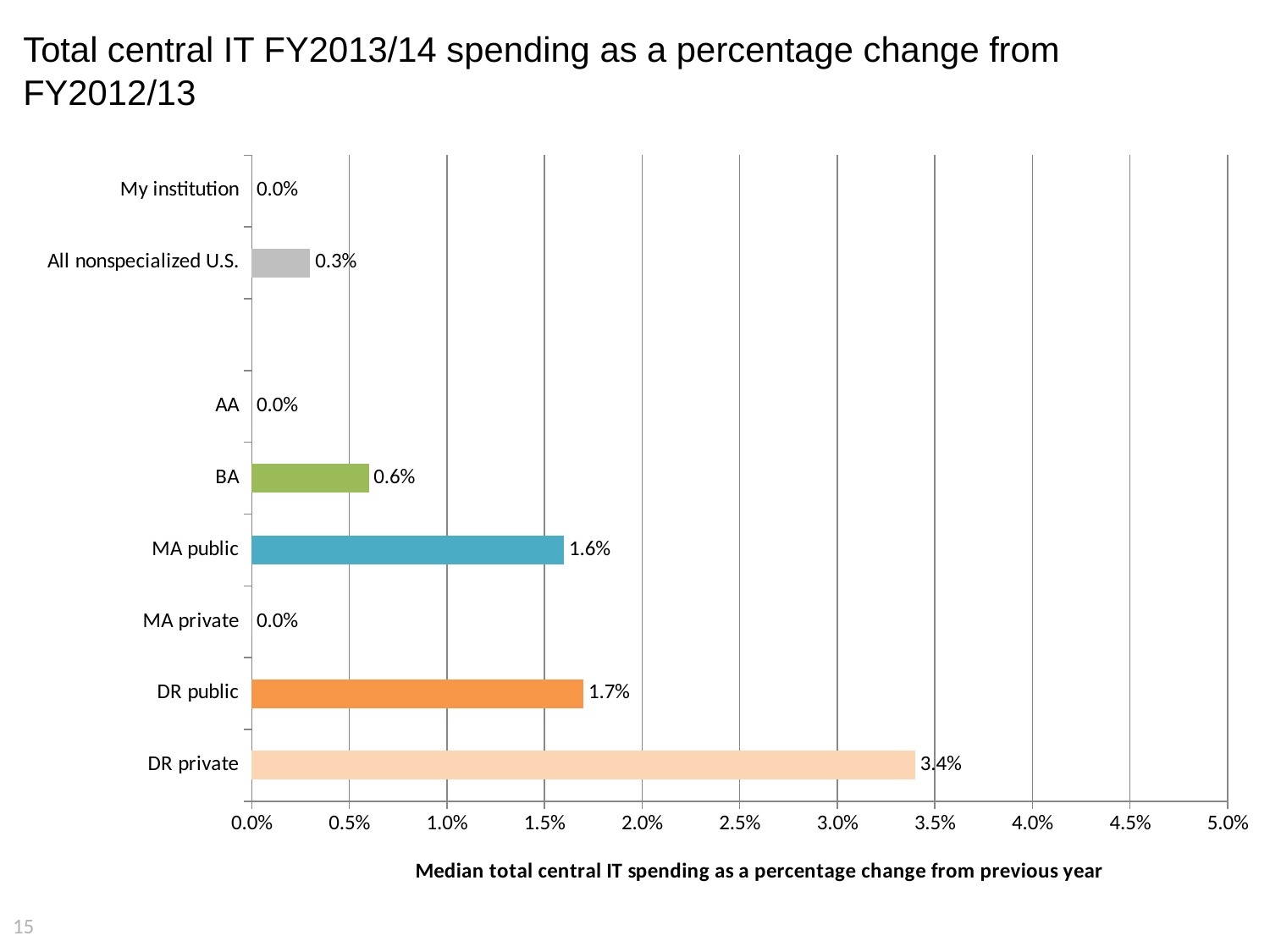
What is the value for MA public? 1.6% Is the value for DR private greater or less than 3.0%? greater Which category has the highest value? DR private What is the title of the horizontal axis? Median total central IT spending as a percentage change from previous year Which is larger, the value for DR public or the value for MA public? DR public What is the difference between the values for DR private and DR public? 1.7% What is the value for BA? 0.6% How many categories are labeled on the vertical axis? 8 What is the value for All nonspecialized U.S.? 0.3% What is the value for DR private? 3.4% What is the difference between the values for MA public and BA? 1.0% What kind of chart is shown on the slide? bar chart